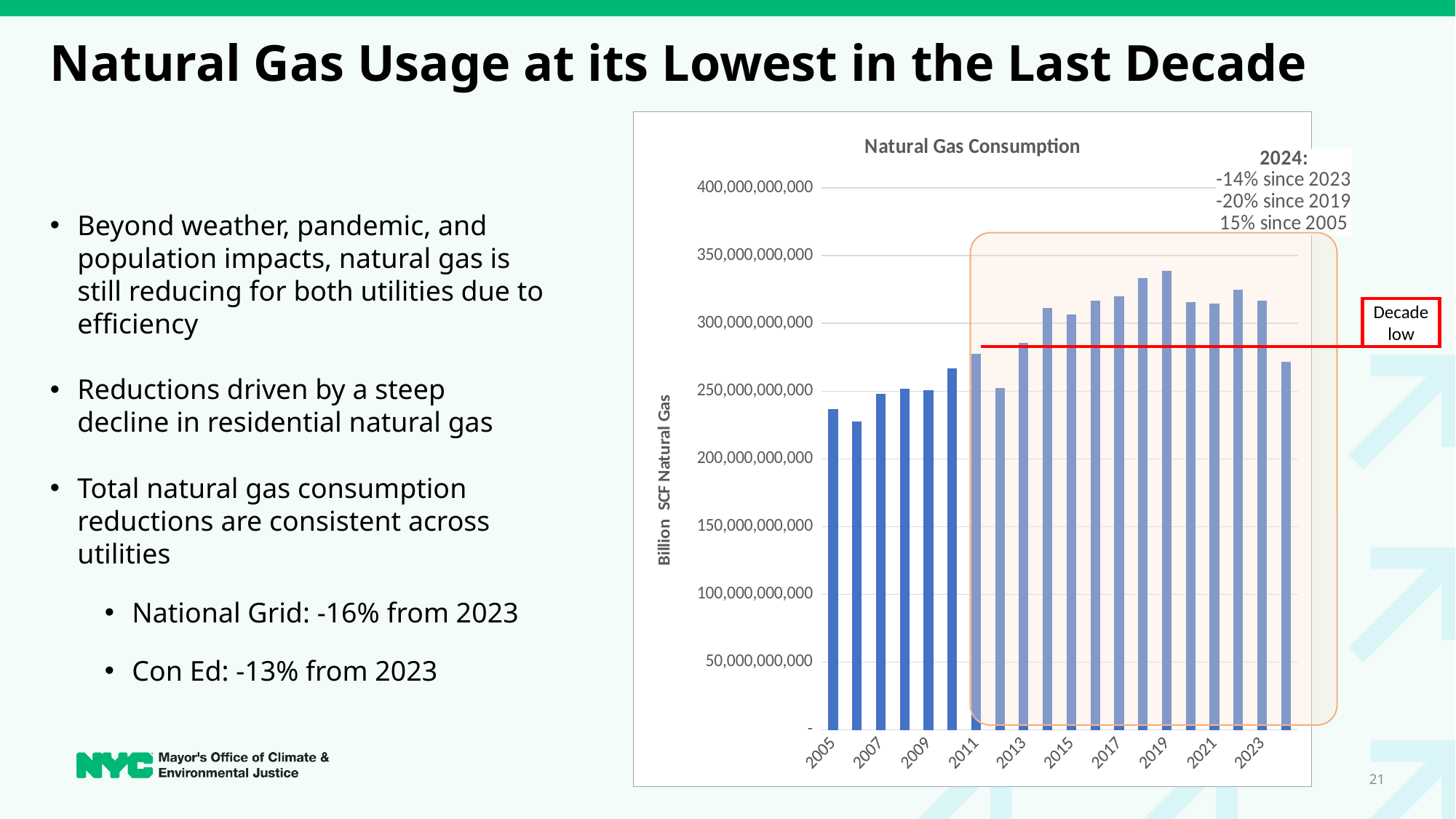
Which year has the lowest natural gas consumption in the chart? 2006 Is the value for 2024 greater or less than 300,000,000,000? less What kind of chart is shown on the slide? Bar chart Which year has the highest natural gas consumption in the chart? 2019 Is the value for 2013 greater or less than 250,000,000,000? greater Which year has the larger natural gas consumption, 2019 or 2024? 2019 What is the label on the vertical axis of the chart? Billion SCF Natural Gas What is the title of the chart? Natural Gas Consumption According to the annotation on the chart, by what percentage did 2024 consumption change since 2023? -14% Is the value for 2005 greater or less than 250,000,000,000? less Do the values rise or fall from 2013 to 2019? rise